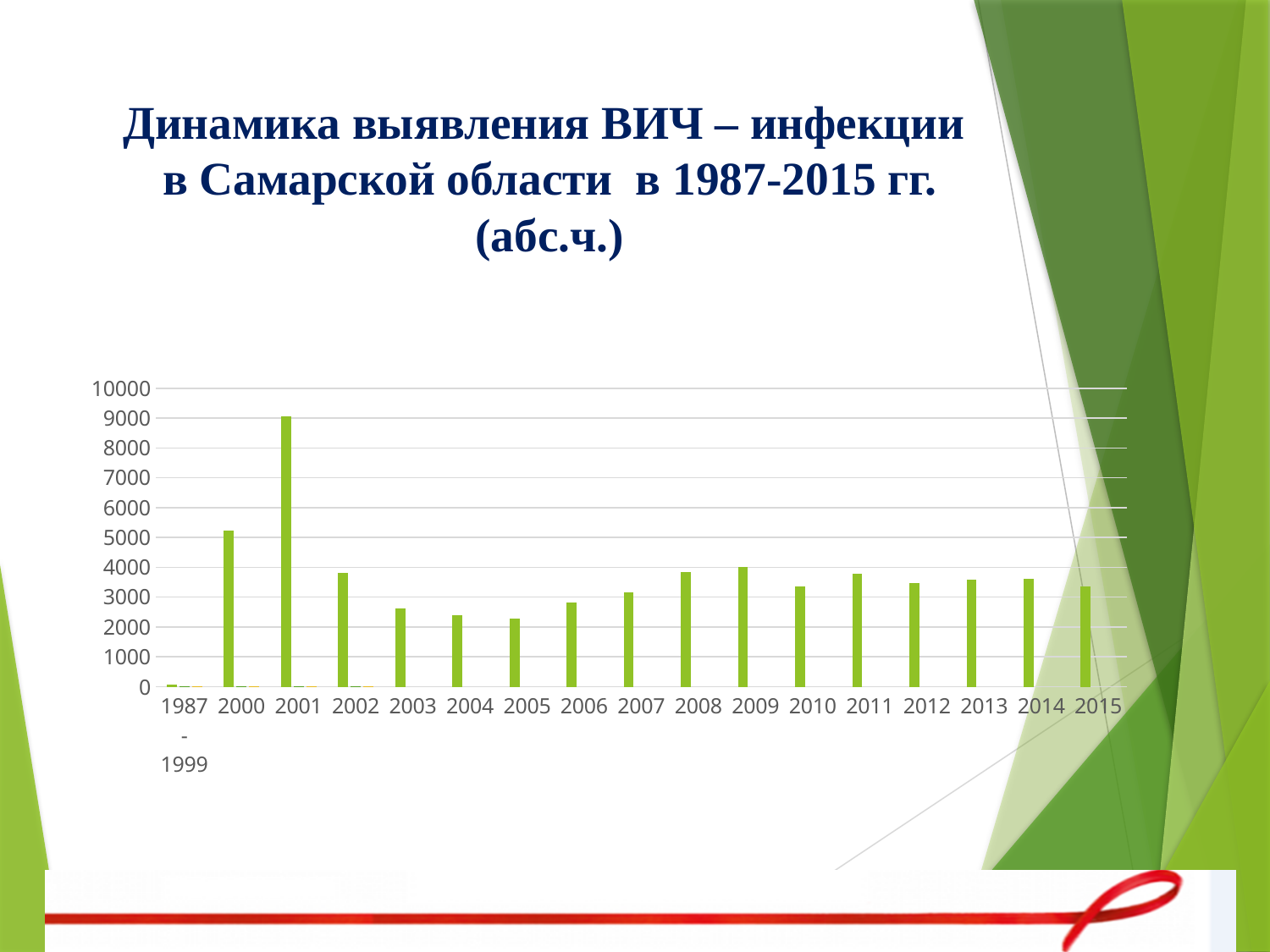
Do the values rise or fall from 2001 to 2005? fall Which category has the lowest bar in the chart? 1987-1999 Which category has the highest bar in the chart? 2001 Is the value for 2001 greater or less than 8000? greater Is the value for 2009 greater or less than 3000? greater Which is larger, the value for 2000 or the value for 2002? 2000 Is the value for 2000 greater or less than 5000? greater Which is larger, the value for 2005 or the value for 2009? 2009 What colour are the bars in the chart? green What kind of chart is shown on the slide? bar chart How many categories are shown on the x axis of the chart? 17